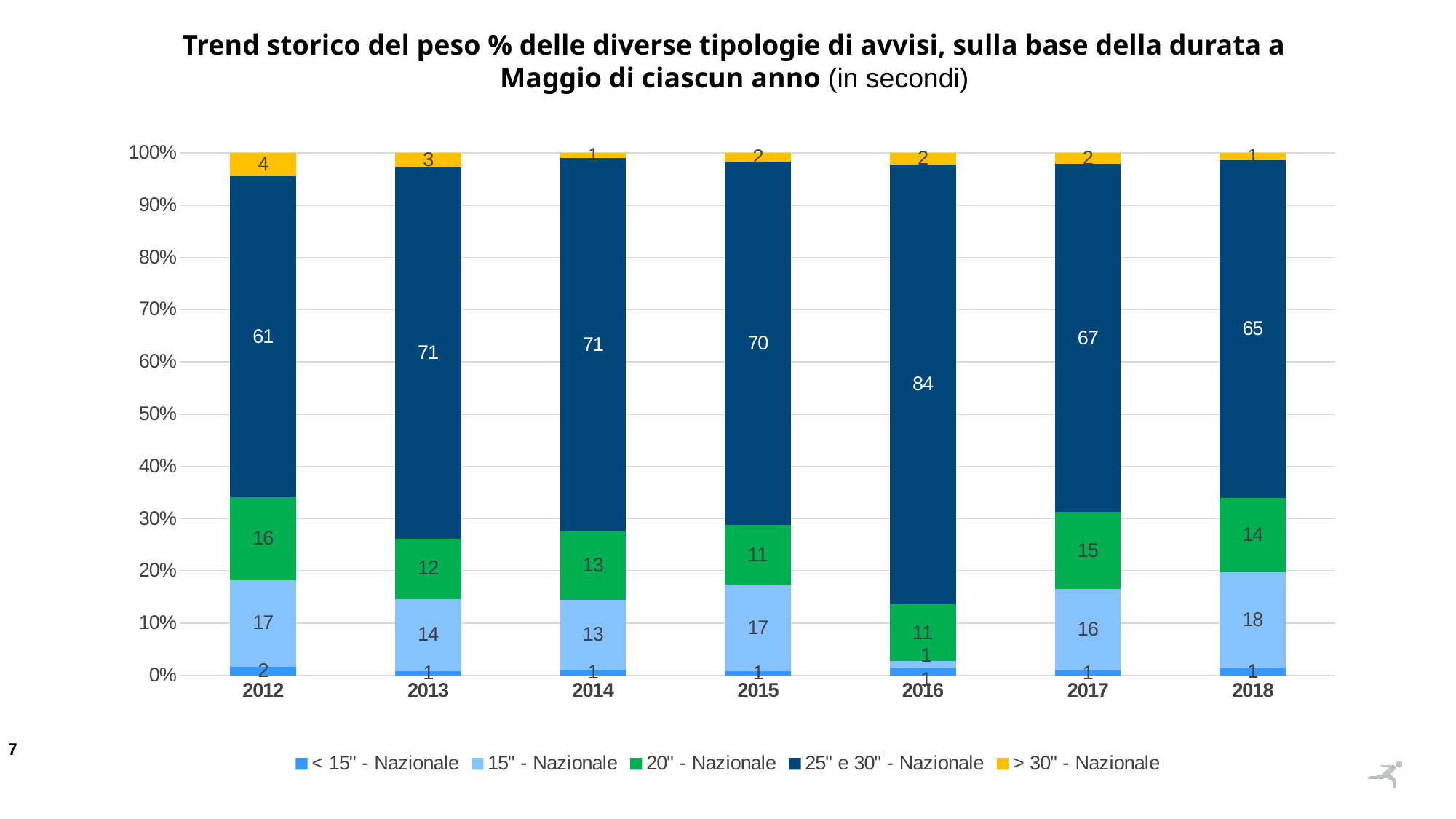
How many years are shown on the x axis? 7 How many series does the legend list? 5 What is the value for the 20'' - Nazionale series in 2012? 16 What is the value for the > 30'' - Nazionale series in 2013? 3 What kind of chart is shown on the slide? Stacked bar chart In which year is the 25'' e 30'' - Nazionale series lowest? 2012 In which year is the 25'' e 30'' - Nazionale series highest? 2016 What is the value for the 15'' - Nazionale series in 2018? 18 What is the difference between the 25'' e 30'' - Nazionale values in 2016 and 2018? 19 Which is larger, the 15'' - Nazionale value in 2015 or in 2014? 2015 Which colour represents the > 30'' - Nazionale series? Yellow What is the value for the 25'' e 30'' - Nazionale series in 2016? 84